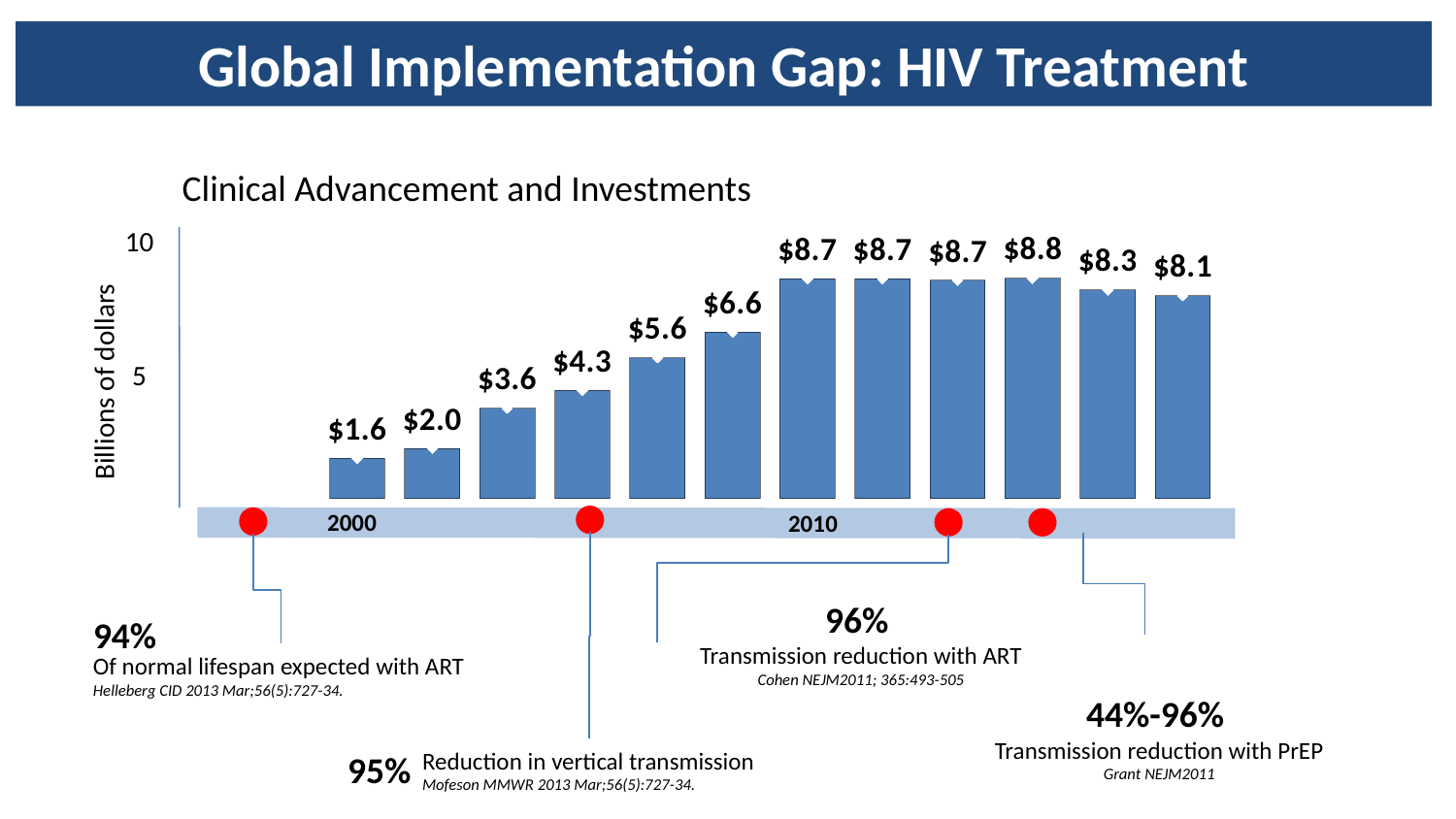
What is the value of the bar above the 2000 label on the timeline? $1.6 Is the value for 2010 greater or less than 5 on the y axis? greater Do the bar values generally rise or fall from 2000 to 2010? rise How many bars are plotted in the chart? 12 What kind of chart is shown on the slide? bar chart What is the difference between the value at 2010 ($8.7) and the value at 2000 ($1.6)? $7.1 What is the lowest value shown on any bar in the chart? $1.6 Which is larger, the value of the first bar or the value of the second bar? the second bar ($2.0) What is the value of the sixth bar from the left? $6.6 What is the value of the bar above the 2010 label on the timeline? $8.7 What is the difference between the highest bar value ($8.8) and the last bar value ($8.1)? $0.7 What is the highest value shown on any bar in the chart? $8.8